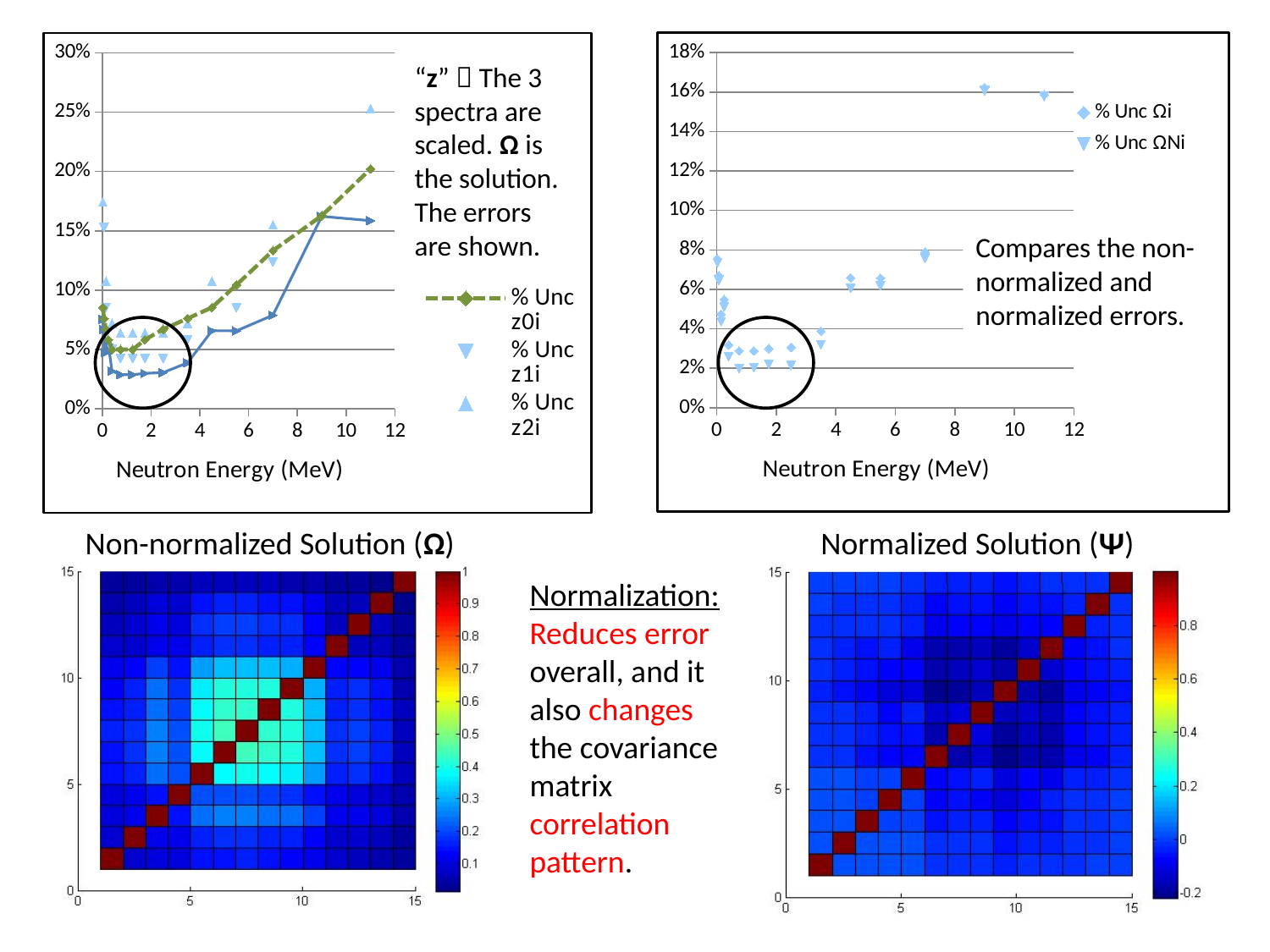
In the top-right chart, how many series does the legend list? 2 In the top-left chart, how many series does the legend list? 3 What is the x-axis title of the top-left chart? Neutron Energy (MeV) In the top-right chart, are the values near 2 MeV greater or less than 4%? less In the top-left chart, does % Unc z0i rise or fall as neutron energy increases from 2 MeV to 11 MeV? rise In the top-left chart, which series has the larger value at 7 MeV, % Unc z0i or % Unc z1i? % Unc z0i What is the title of the bottom-right heatmap? Normalized Solution (Ψ) What kind of chart is the top-right chart? Scatter chart In the top-left chart, which series has the larger value at 11 MeV, % Unc z2i or % Unc z0i? % Unc z2i In the top-left chart, is the value of % Unc z0i at 9 MeV greater or less than 15%? greater In the top-left chart, is the value of % Unc z2i at 11 MeV greater or less than 20%? greater